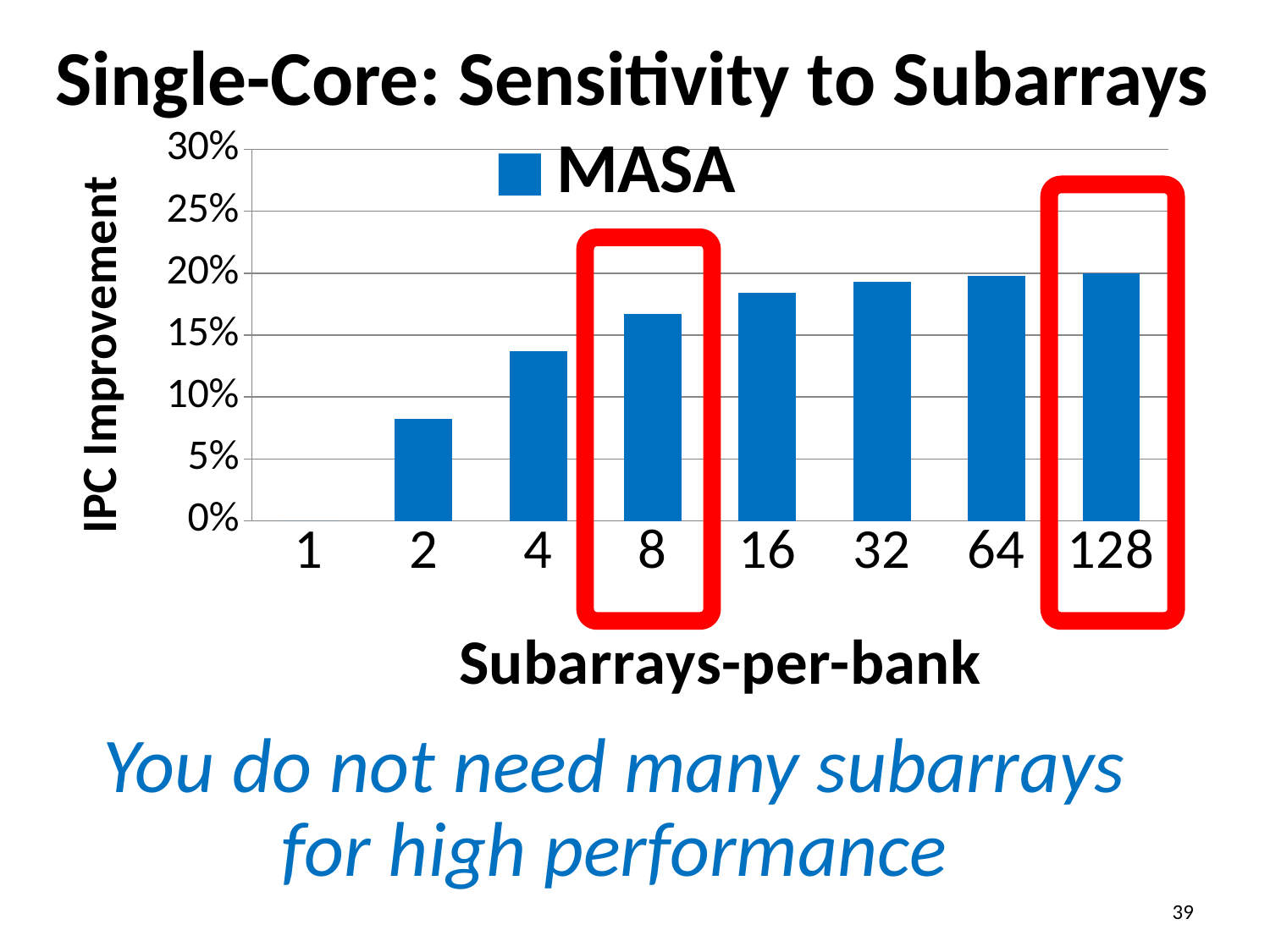
Do the IPC improvement values rise or fall as subarrays-per-bank increases along the x axis? rise What is the name of the series shown in the legend? MASA Is the IPC improvement for 16 subarrays-per-bank greater or less than 20%? less Is the IPC improvement for 2 subarrays-per-bank greater or less than 10%? less Which has a larger IPC improvement, 2 subarrays-per-bank or 8 subarrays-per-bank? 8 What is the label of the y axis? IPC Improvement What kind of chart is shown on the slide? bar chart Is the IPC improvement for 4 subarrays-per-bank greater or less than 10%? greater How many subarrays-per-bank categories are shown on the x axis? 8 How many series does the legend list? 1 Which subarrays-per-bank value has the lowest IPC improvement? 1